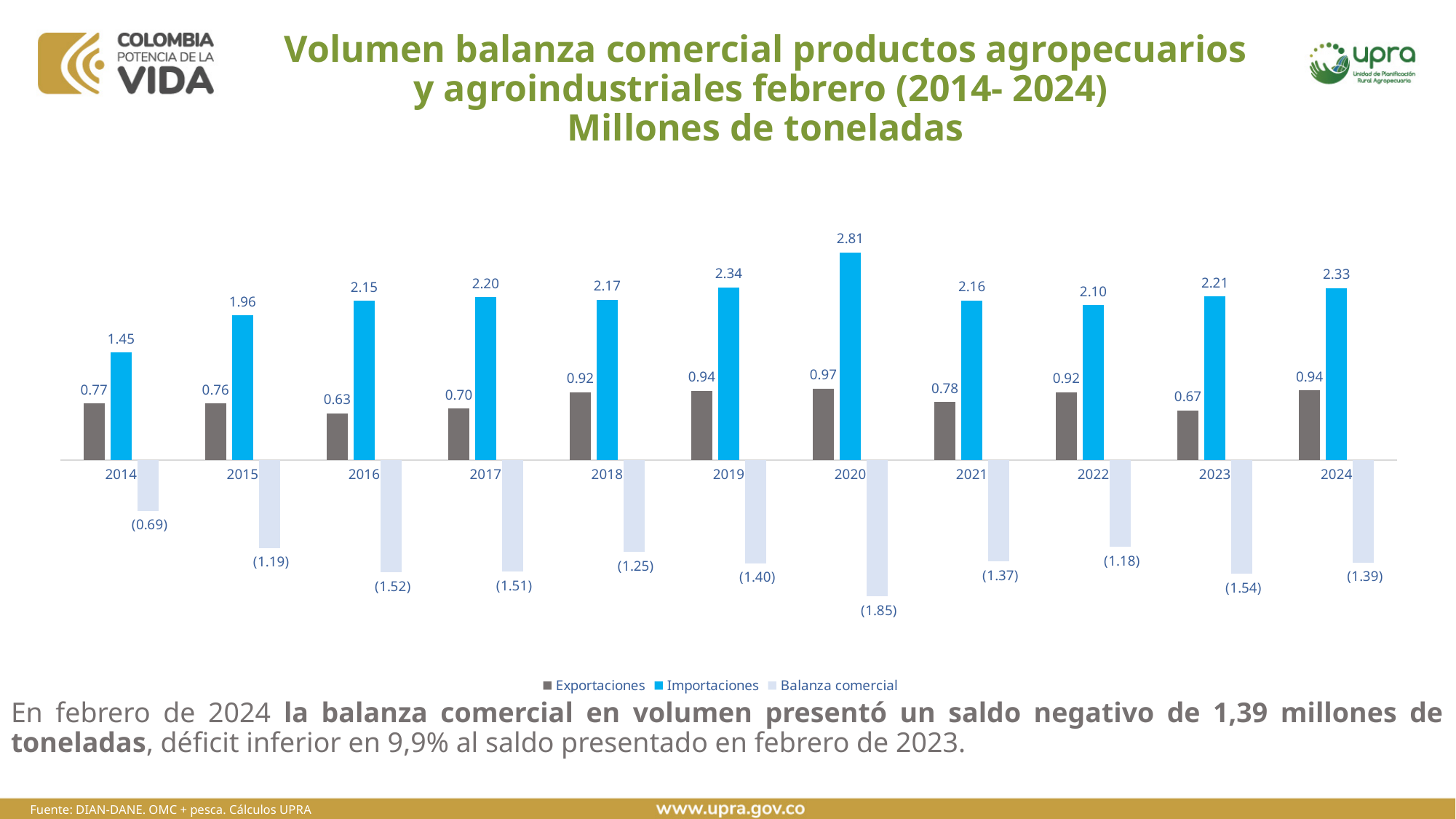
What is the value of Exportaciones for 2016? 0.63 What is the Balanza comercial value shown for 2024? (1.39) What is the value of Importaciones for 2020? 2.81 Which series is shown in light blue bars below the axis? Balanza comercial What kind of chart is shown on the slide? Bar chart Which year has the lowest Exportaciones value? 2016 Which is larger in 2014, Exportaciones or Importaciones? Importaciones What is the difference between Importaciones and Exportaciones in 2024? 1.39 How many years are shown on the x axis? 11 How many series does the legend list? 3 Did Importaciones rise or fall from 2014 to 2015? Rise Which year has the highest Importaciones value? 2020